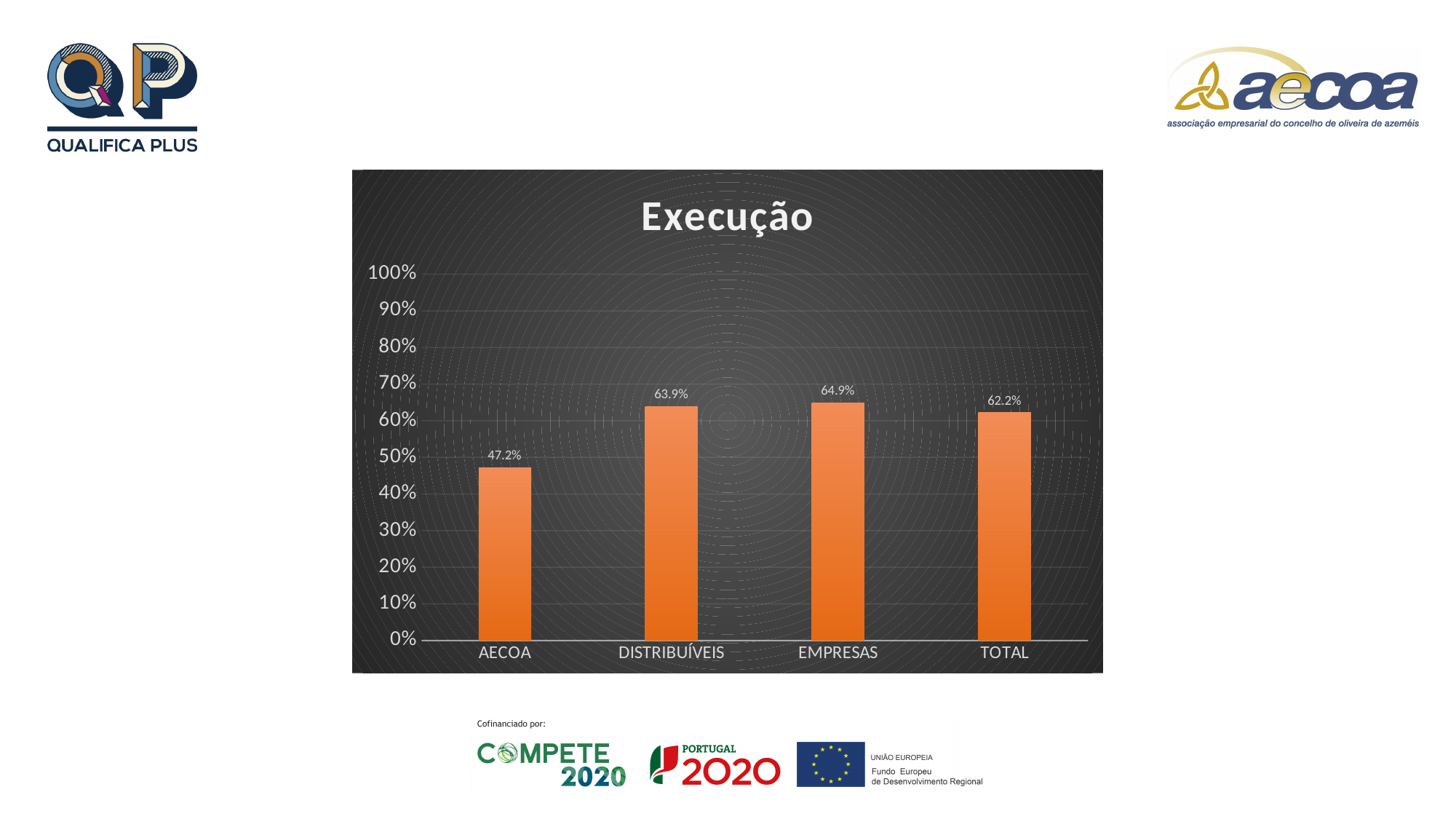
What is the difference between the values for EMPRESAS and AECOA? 17.7% How many categories are shown on the x axis? 4 Which category has the highest value? EMPRESAS Which is larger, the value for DISTRIBUÍVEIS or the value for TOTAL? DISTRIBUÍVEIS What is the value for DISTRIBUÍVEIS? 63.9% What is the value for AECOA? 47.2% Is the value for AECOA greater or less than 50%? less What kind of chart is shown? bar chart What is the value for TOTAL? 62.2% What is the title of the chart? Execução What is the value for EMPRESAS? 64.9% Which category has the lowest value? AECOA